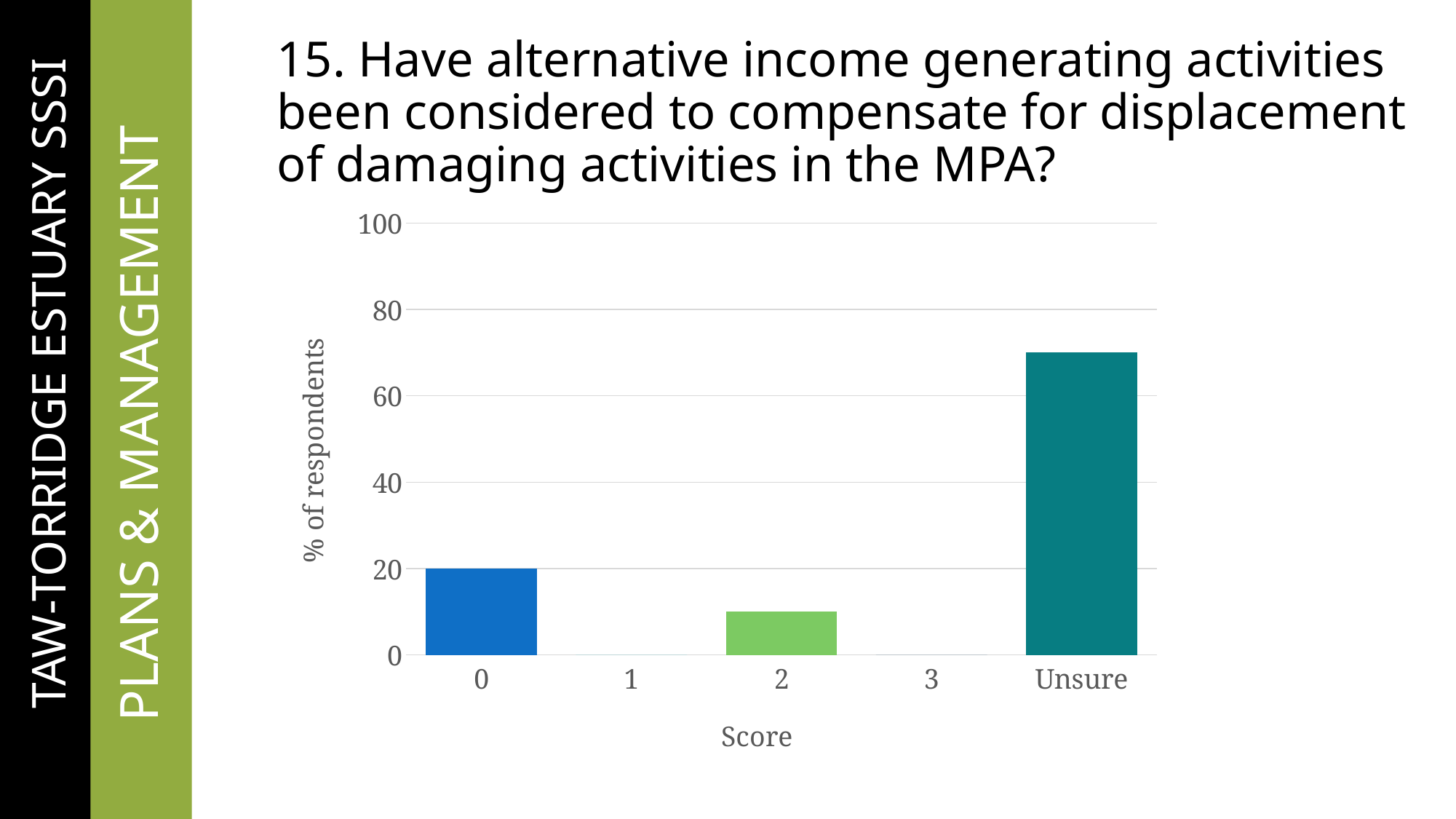
What is the label of the y axis of the chart? % of respondents Which is larger, the value for Unsure or the value for score 0? Unsure Is the value for Unsure greater or less than 80? less Which category has the highest value in the chart? Unsure What kind of chart is shown on the slide? bar chart How many categories are shown on the x axis of the chart? 5 Which is larger, the value for score 0 or the value for score 2? score 0 Is the value for score 0 greater or less than 40? less Is the value for Unsure greater or less than 60? greater What is the value for score 0 in the chart? 20 What is the label of the x axis of the chart? Score